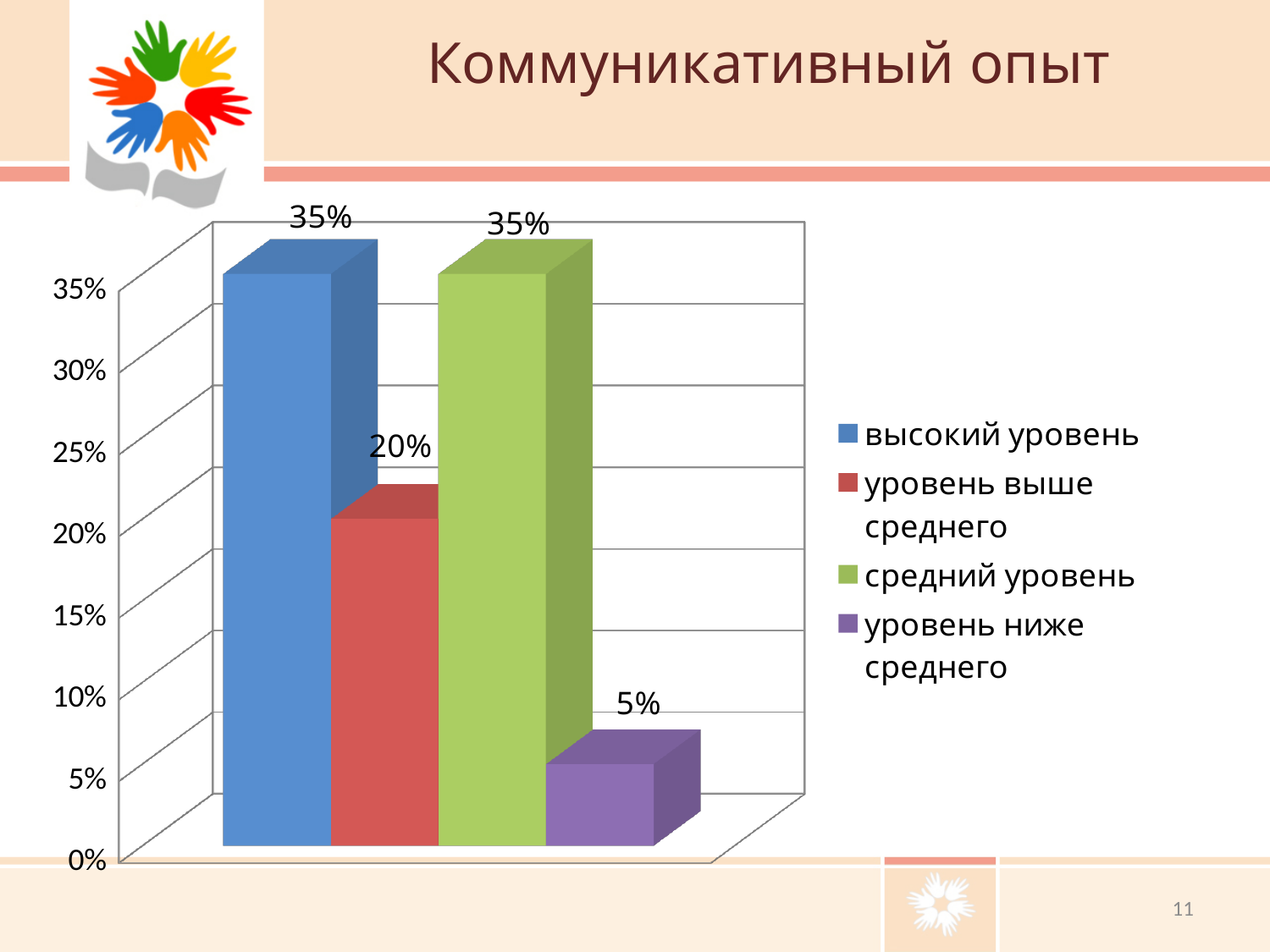
Which is larger, the value for уровень выше среднего or the value for уровень ниже среднего? уровень выше среднего Which category has the lowest value? уровень ниже среднего What is the value for уровень ниже среднего? 5% Is the value for уровень выше среднего greater or less than 15%? greater How many bars are plotted in the chart? 4 What is the value for средний уровень? 35% What is the difference between the values for средний уровень and уровень ниже среднего? 30% What is the value for высокий уровень? 35% How many entries does the legend list? 4 What is the value for уровень выше среднего? 20% What is the difference between the values for высокий уровень and уровень выше среднего? 15% What is the title of the slide containing the chart? Коммуникативный опыт